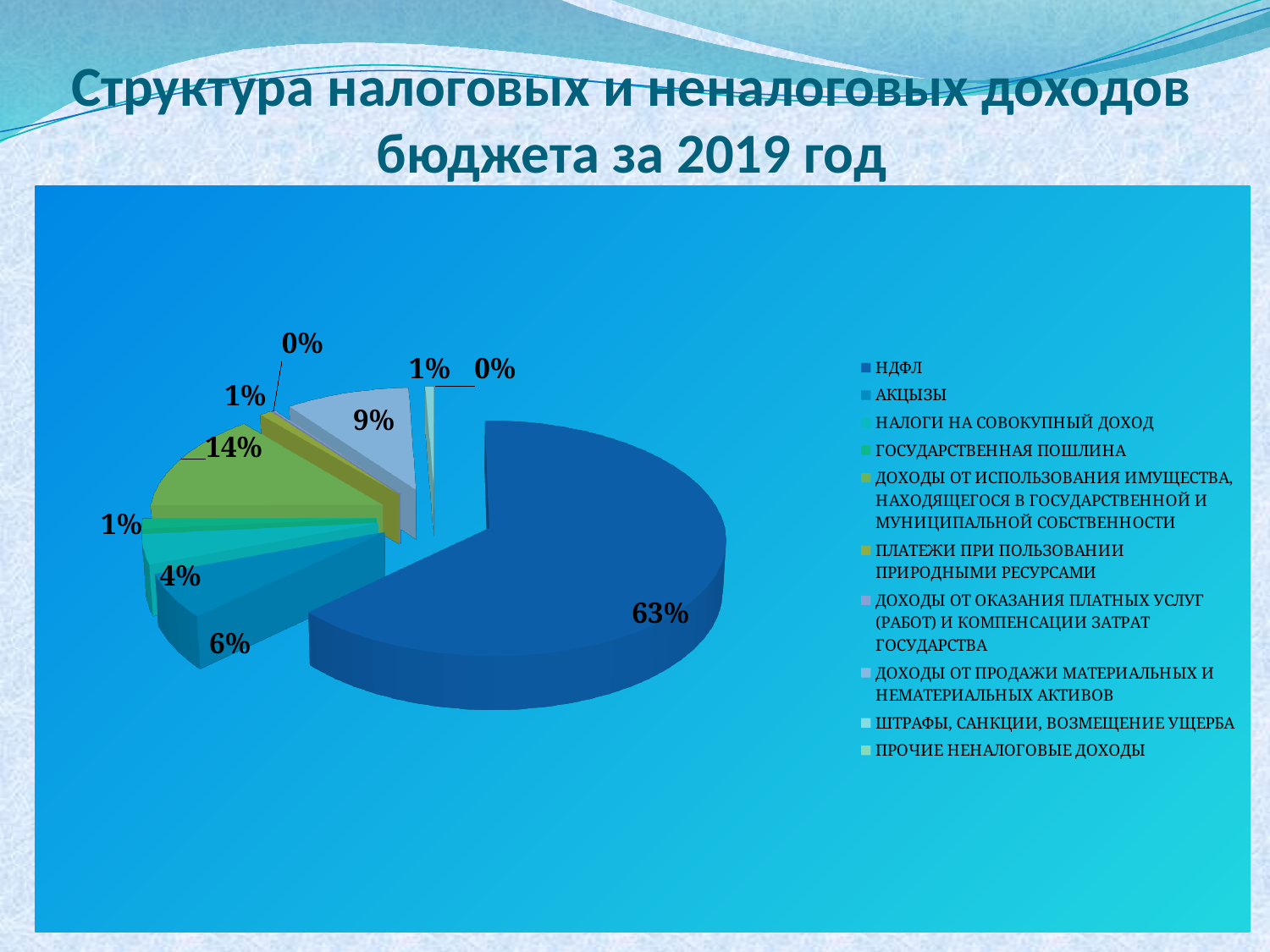
Which category has the largest slice of the pie? НДФЛ How many entries does the legend of the pie chart list? 10 What share of the pie is labelled for ДОХОДЫ ОТ ИСПОЛЬЗОВАНИЯ ИМУЩЕСТВА, НАХОДЯЩЕГОСЯ В ГОСУДАРСТВЕННОЙ И МУНИЦИПАЛЬНОЙ СОБСТВЕННОСТИ? 14% What share of the pie does НДФЛ account for? 63% What kind of chart is shown on the slide? pie chart What is the title of the chart on the slide? Структура налоговых и неналоговых доходов бюджета за 2019 год What share of the pie is labelled for ДОХОДЫ ОТ ПРОДАЖИ МАТЕРИАЛЬНЫХ И НЕМАТЕРИАЛЬНЫХ АКТИВОВ? 9% Which is larger: the share for НДФЛ or the share for ДОХОДЫ ОТ ИСПОЛЬЗОВАНИЯ ИМУЩЕСТВА, НАХОДЯЩЕГОСЯ В ГОСУДАРСТВЕННОЙ И МУНИЦИПАЛЬНОЙ СОБСТВЕННОСТИ? НДФЛ What is the difference in percentage points between the НДФЛ share (63%) and the ДОХОДЫ ОТ ПРОДАЖИ МАТЕРИАЛЬНЫХ И НЕМАТЕРИАЛЬНЫХ АКТИВОВ share (9%)? 54 How many slices in the pie chart are labelled 0%? 2